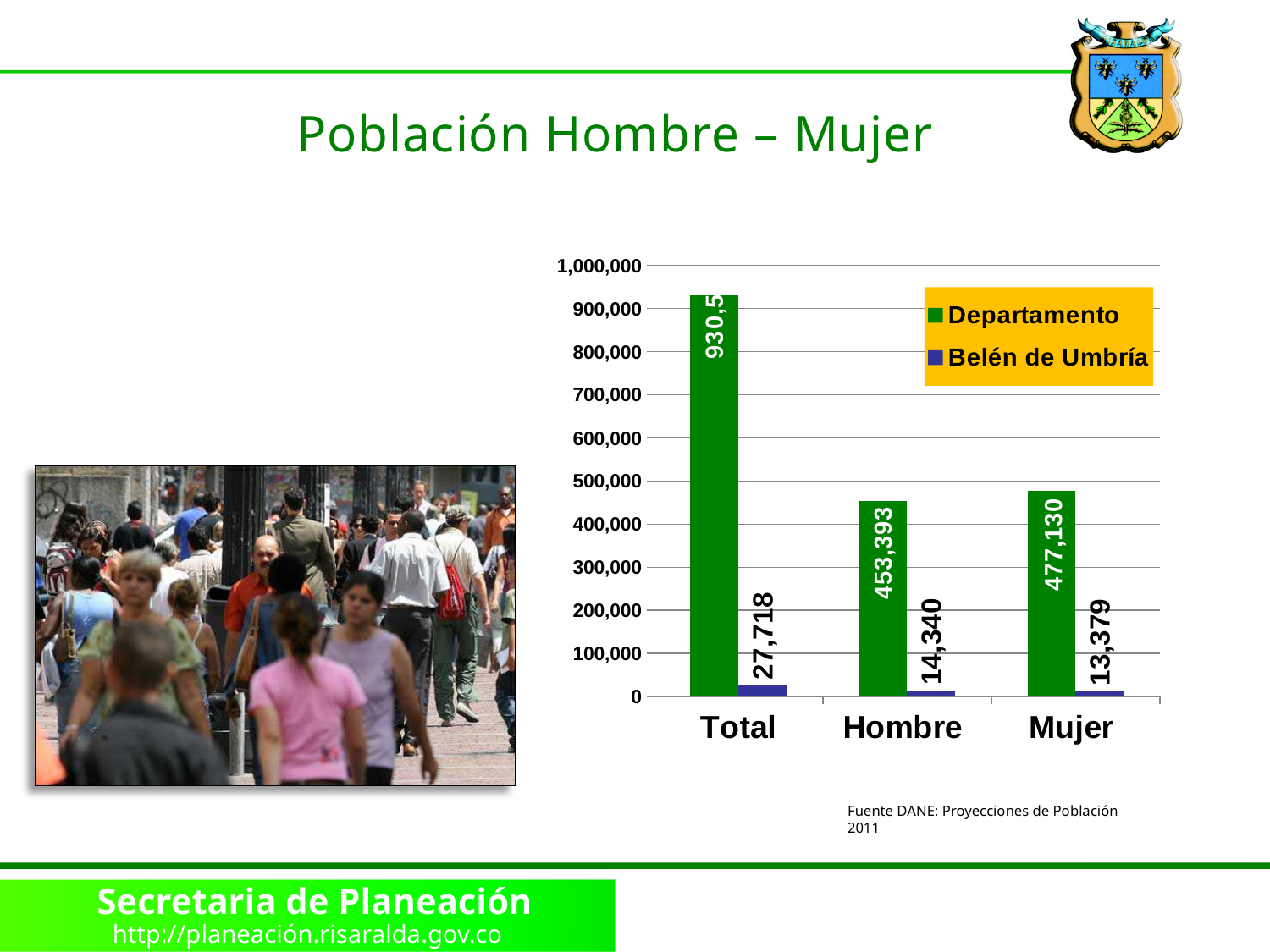
What type of chart is shown on the slide? bar chart What is the Belén de Umbría value for Total? 27,718 Is the Departamento value for Total greater or less than 900,000? greater What is the Departamento value for Mujer? 477,130 Which is larger for Belén de Umbría, Hombre or Mujer? Hombre What is the Departamento value for Hombre? 453,393 What is the difference between the Departamento values for Mujer and Hombre? 23,737 Which is larger for Departamento, Hombre or Mujer? Mujer What is the Belén de Umbría value for Hombre? 14,340 What is the Belén de Umbría value for Mujer? 13,379 How many categories are shown on the x axis? 3 How many series does the legend list? 2